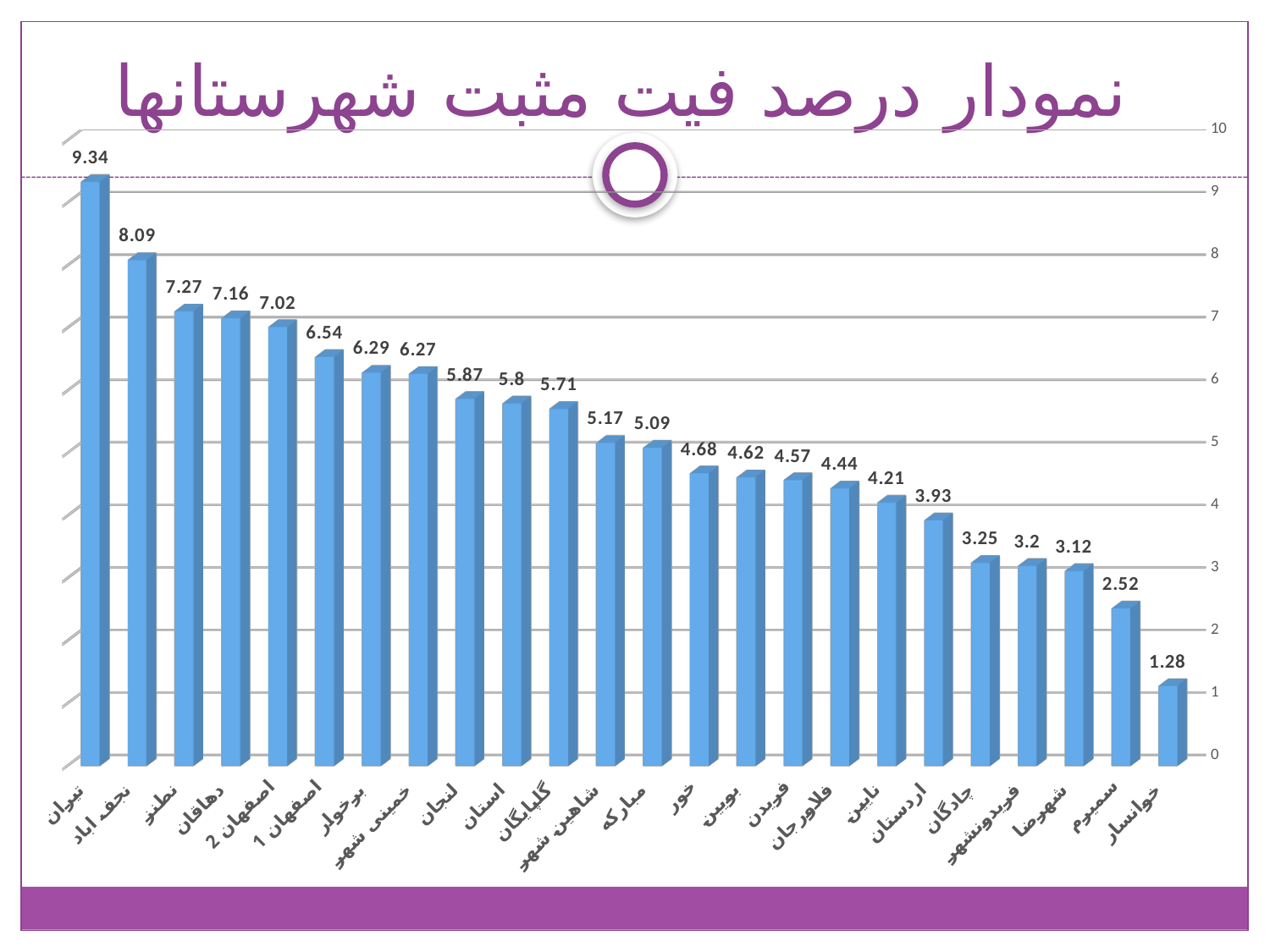
Which category has the lowest value? خوانسار What is the title of the chart? نمودار درصد فیت مثبت شهرستانها What type of chart is shown on the slide? bar chart What is the value for خوانسار? 1.28 What is the value for گلپایگان? 5.71 What is the value for اردستان? 3.93 What is the difference between the values for تیران and نجف آباد? 1.25 How many categories are shown on the x axis? 24 Which category has the highest value? تیران Do the values rise or fall from left to right along the x axis? fall What is the value for تیران? 9.34 Which has a larger value, مبارکه or شهرضا? مبارکه